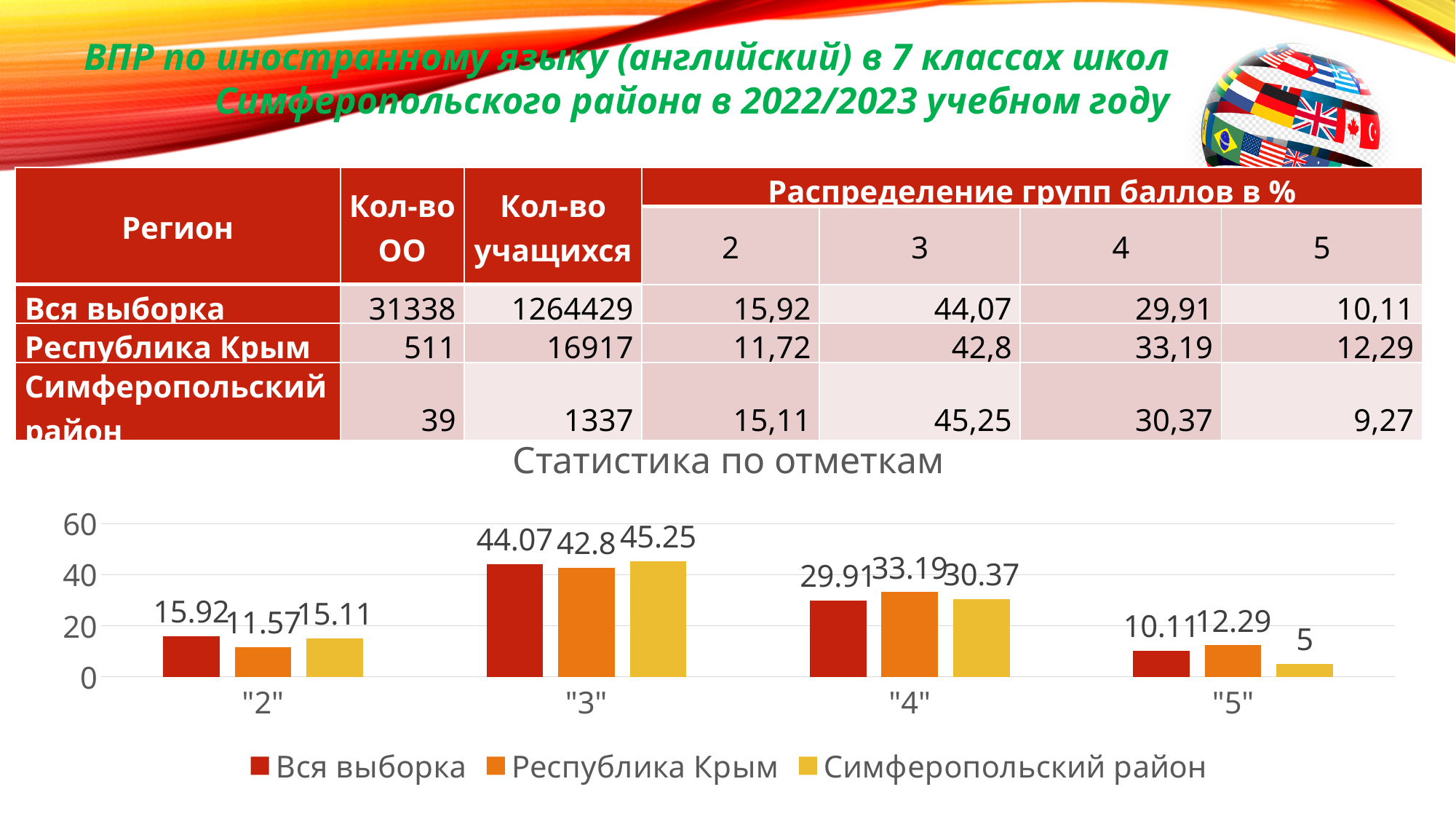
In the "Статистика по отметкам" chart, what is the value for Симферопольский район in category "3"? 45.25 How many categories are shown on the x axis of the "Статистика по отметкам" chart? 4 In the "Статистика по отметкам" chart, is the value for Симферопольский район in category "4" greater or less than 20? greater In the "Статистика по отметкам" chart, which series is shown in yellow? Симферопольский район In the "Статистика по отметкам" chart, what is the value for Вся выборка in category "5"? 10.11 In the "Статистика по отметкам" chart, which category has the lowest value for Симферопольский район? "5" In the "Статистика по отметкам" chart, what is the difference between Республика Крым and Симферопольский район in category "5"? 7.29 In the "Статистика по отметкам" chart, what is the value for Республика Крым in category "4"? 33.19 In the "Статистика по отметкам" chart, which category has the highest value for Вся выборка? "3" How many series does the legend of the "Статистика по отметкам" chart list? 3 What type of chart is shown under the title "Статистика по отметкам"? bar chart In the "Статистика по отметкам" chart, which is larger in category "2": Вся выборка or Республика Крым? Вся выборка